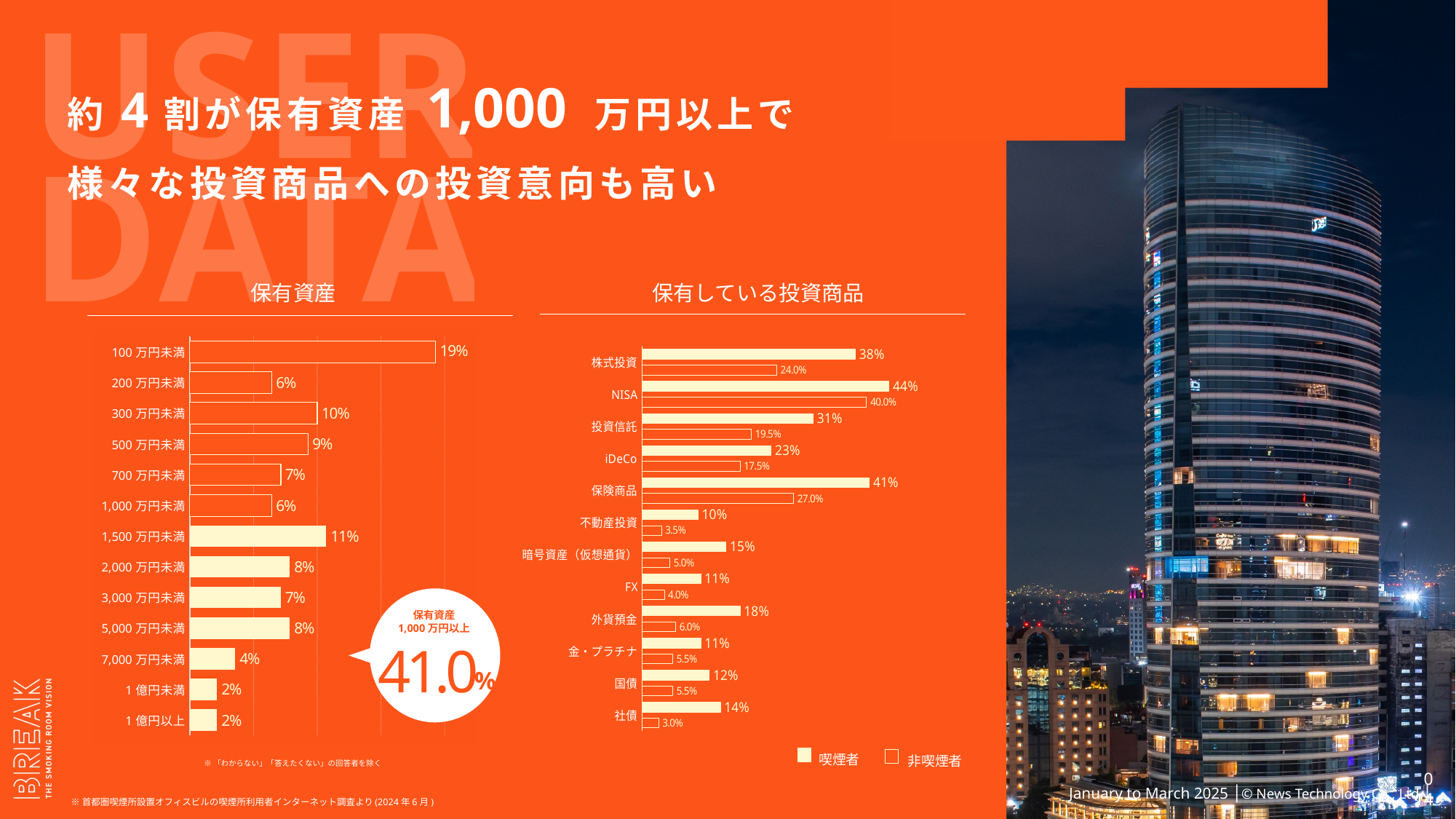
In the 保有資産 chart, what is the value for 7,000万円未満? 4% In the 保有している投資商品 chart, which category has the highest 喫煙者 value? NISA In the 保有している投資商品 chart, what is the 喫煙者 value for NISA? 44% In the 保有している投資商品 chart, which is larger for 株式投資: 喫煙者 or 非喫煙者? 喫煙者 In the 保有資産 chart, what is the value for 100万円未満? 19% In the 保有している投資商品 chart, which category has the lowest 非喫煙者 value? 社債 What kind of chart is the 保有している投資商品 chart? Bar chart In the 保有している投資商品 chart, what is the 非喫煙者 value for 保険商品? 27.0% In the 保有している投資商品 chart, how many series does the legend list? 2 In the 保有資産 chart, how many categories are shown? 13 In the 保有資産 chart, what is the difference between 1,500万円未満 and 2,000万円未満? 3% In the 保有資産 chart, which category has the highest value? 100万円未満